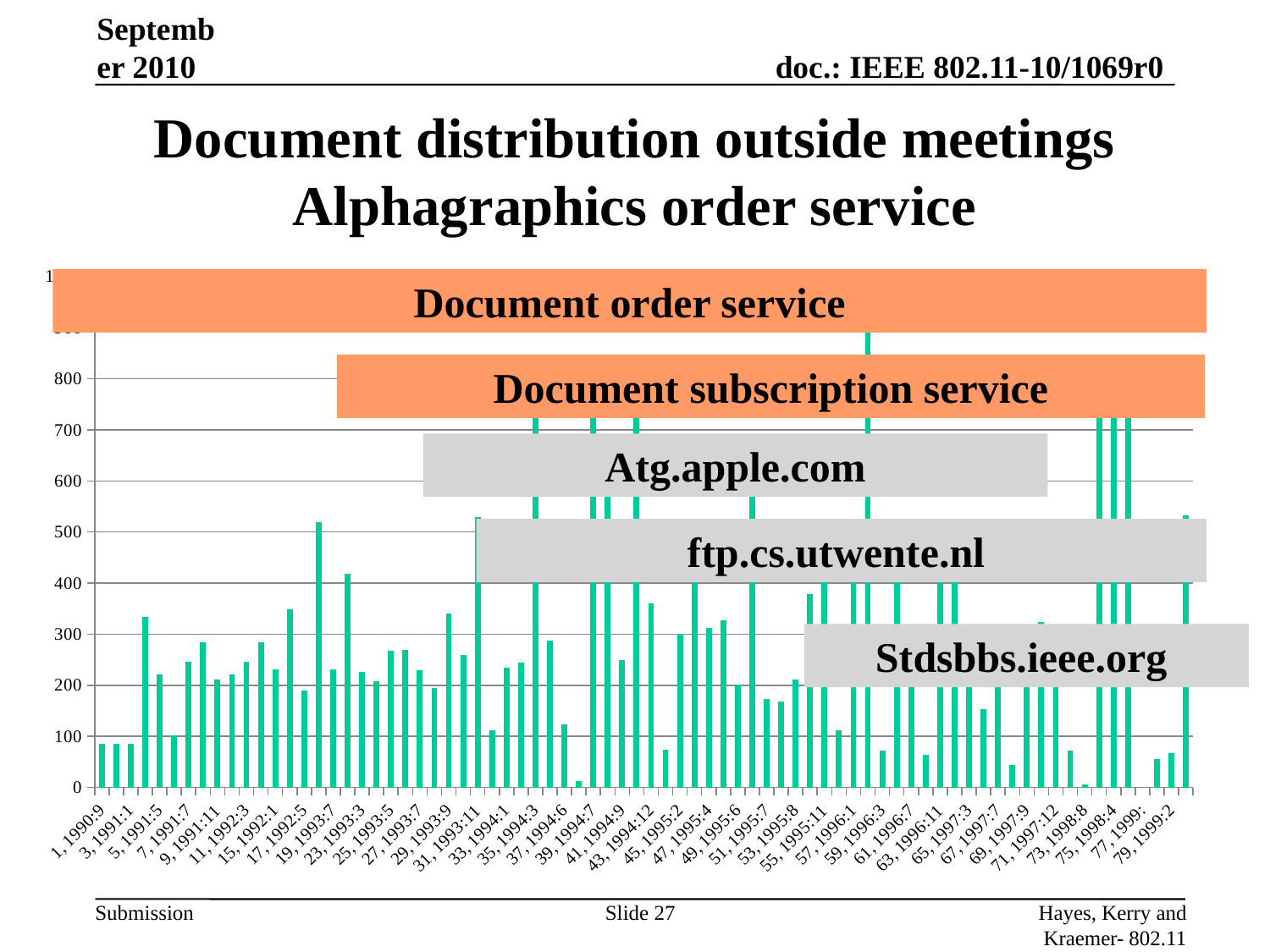
Is the value for the category "3, 1991:1" greater or less than 100? less What is the lowest tick value shown on the vertical axis? 0 Is the tallest bar in the chart greater or less than 800? greater What kind of chart is shown on the slide? bar chart What text is shown in the topmost orange box overlaid on the chart? Document order service Is the value for the first category, "1, 1990:9", greater or less than 100? less What is the title of the slide containing the chart? Document distribution outside meetings Alphagraphics order service